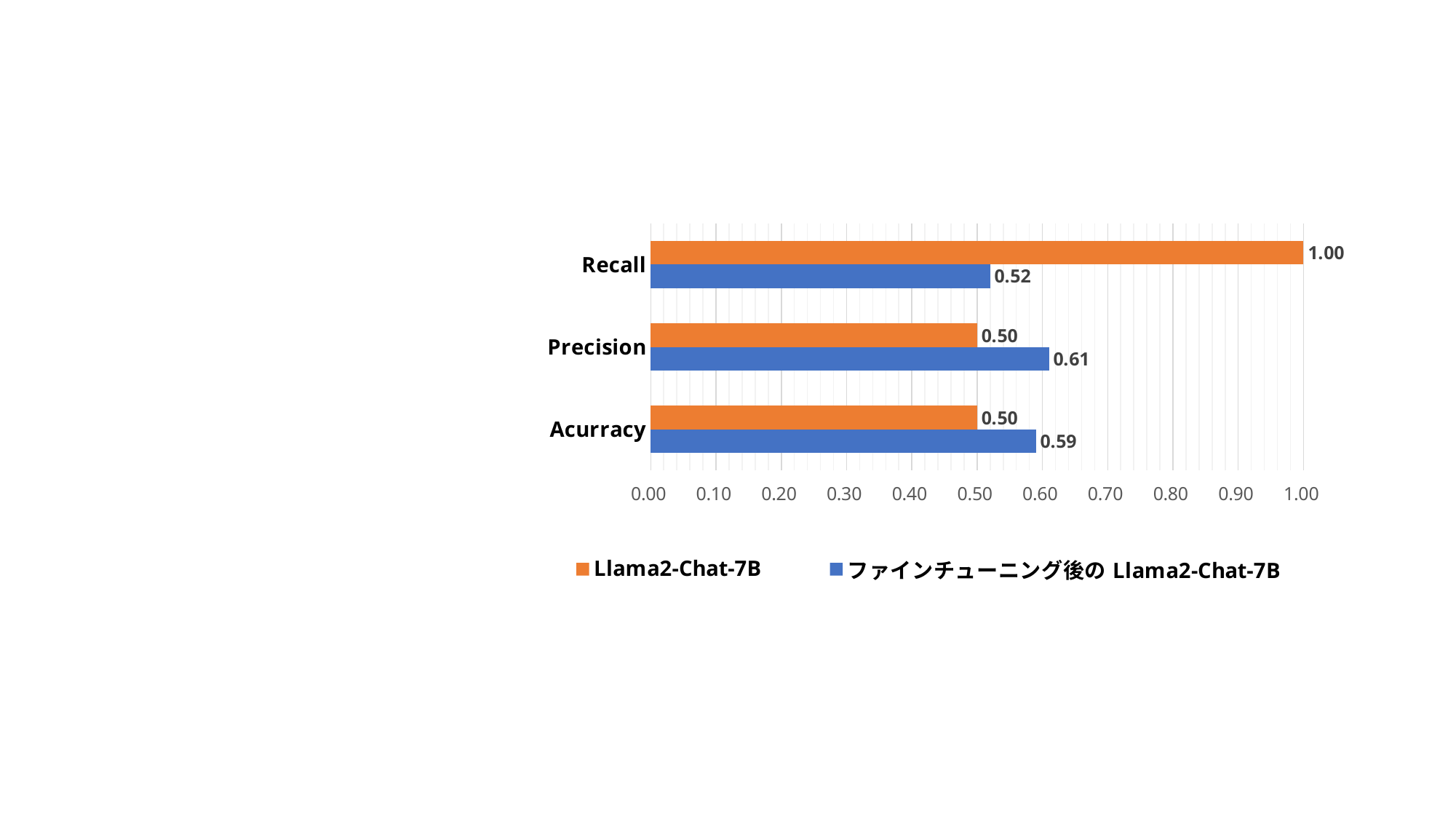
What is the Recall value for Llama2-Chat-7B? 1.00 What is the Recall value for ファインチューニング後の Llama2-Chat-7B? 0.52 For Precision, which series has the larger value: Llama2-Chat-7B or ファインチューニング後の Llama2-Chat-7B? ファインチューニング後の Llama2-Chat-7B What is the difference between the Recall values of Llama2-Chat-7B and ファインチューニング後の Llama2-Chat-7B? 0.48 What is the Acurracy value for Llama2-Chat-7B? 0.50 How many series does the legend list? 2 Which category has the lowest value for ファインチューニング後の Llama2-Chat-7B? Recall Which colour represents Llama2-Chat-7B in the chart? Orange What is the Precision value for ファインチューニング後の Llama2-Chat-7B? 0.61 Which category has the highest value for Llama2-Chat-7B? Recall What kind of chart is shown on the slide? Bar chart How many categories are shown on the chart? 3